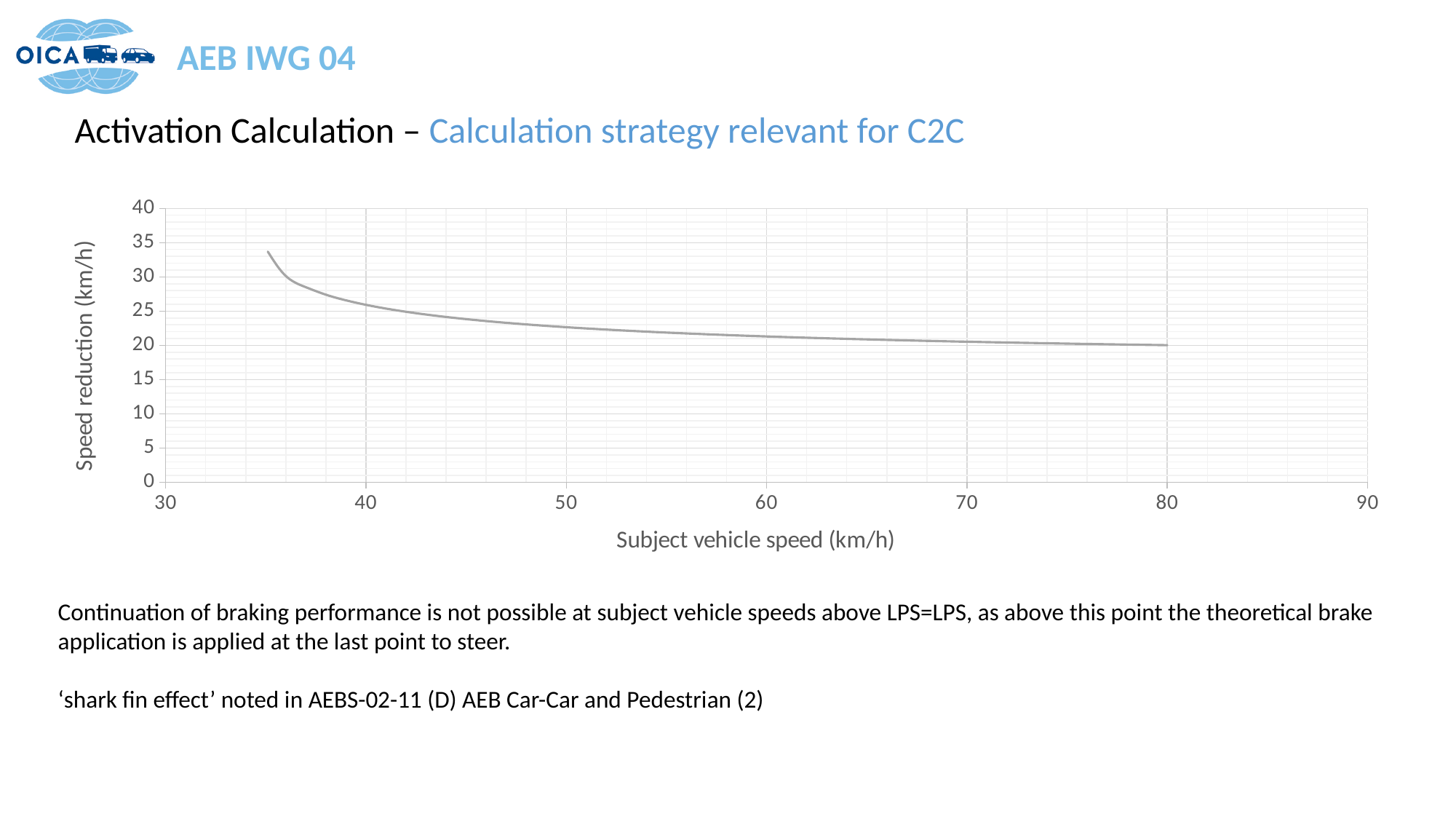
Is the speed reduction at a subject vehicle speed of 35 km/h greater or less than 30 km/h? greater What is the title of the y axis? Speed reduction (km/h) What kind of chart is shown on the slide? line chart What is the title of the x axis? Subject vehicle speed (km/h) Is the speed reduction at a subject vehicle speed of 80 km/h greater or less than 25 km/h? less Is the speed reduction at a subject vehicle speed of 50 km/h greater or less than 20 km/h? greater Which subject vehicle speed has the higher speed reduction, 40 km/h or 70 km/h? 40 km/h Does the speed reduction rise or fall as subject vehicle speed increases along the x axis? fall